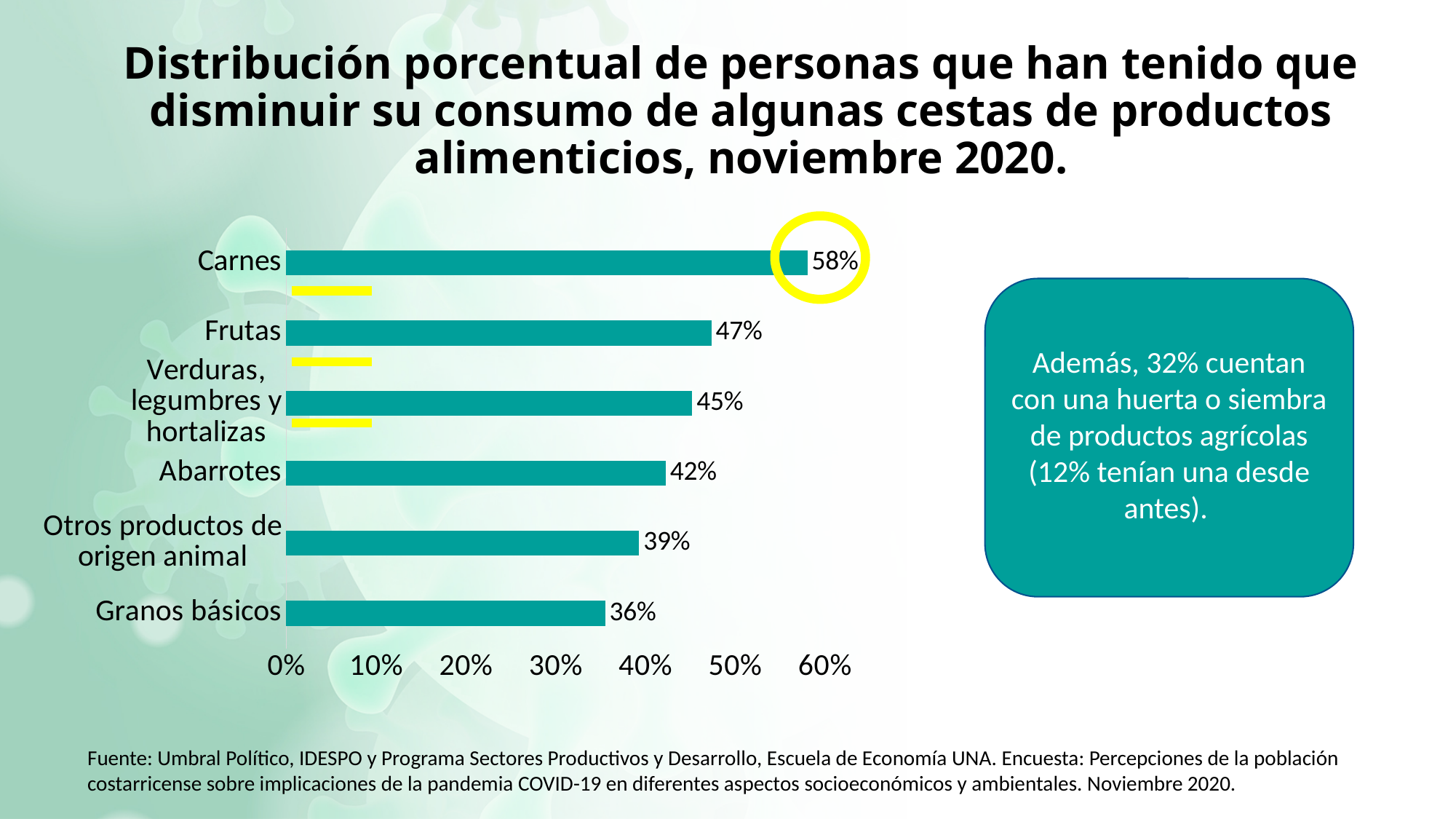
Which category has the highest percentage? Carnes What is the difference between the values for Carnes and Granos básicos? 22% Which category has the lowest percentage? Granos básicos What kind of chart is shown on the slide? Bar chart What is the value shown for Frutas? 47% What is the value for Granos básicos? 36% What percentage of people reduced their consumption of Carnes? 58% Is the value for Otros productos de origen animal greater or less than 40%? less What is the difference between the values for Abarrotes and Otros productos de origen animal? 3% What percentage is shown for Verduras, legumbres y hortalizas? 45% How many categories are shown in the chart? 6 Which is larger, the value for Frutas or the value for Abarrotes? Frutas